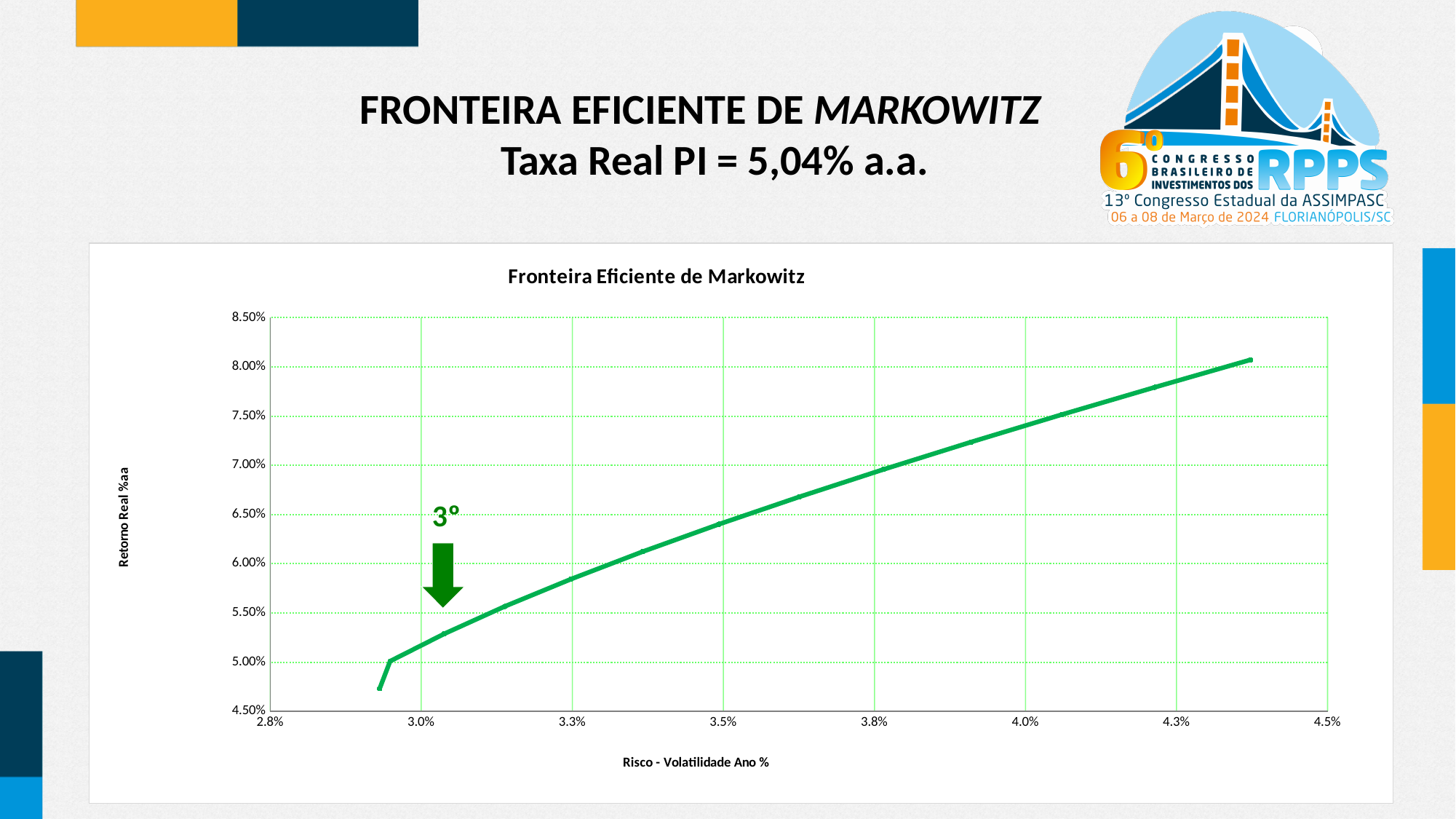
Is the return value on the curve at a risk of 4.0% greater or less than 7.00%? greater Is the return value on the curve at a risk of 3.0% greater or less than 5.50%? less What kind of chart is shown on the slide? Line chart What is the title of the chart? Fronteira Eficiente de Markowitz Is the return value on the curve at a risk of 3.5% greater or less than 7.00%? less What is the label of the x axis of the chart? Risco - Volatilidade Ano % What is the highest value shown on the y axis of the chart? 8.50% Does the return (Retorno Real %aa) rise or fall as risk (Risco - Volatilidade Ano %) increases along the x axis? Rise